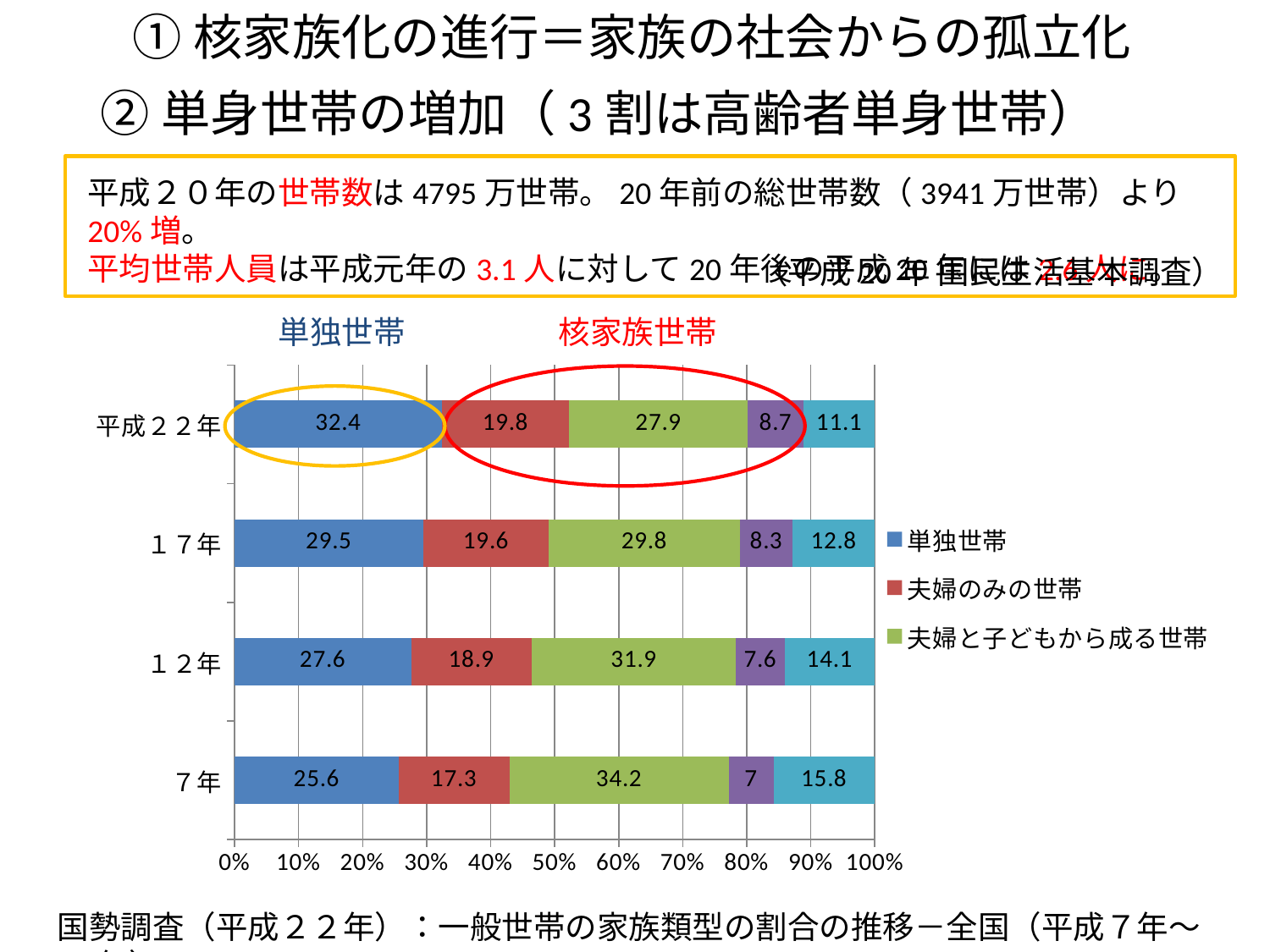
Does the value for 単独世帯 rise or fall from 7年 to 平成22年? Rise Which year has the highest value for 単独世帯? 平成22年 How many years (categories) are shown in the chart? 4 What is the difference between the 夫婦と子どもから成る世帯 value in 7年 and in 平成22年? 6.3 In 12年, which is larger: 単独世帯 or 夫婦と子どもから成る世帯? 夫婦と子どもから成る世帯 What is the value for 夫婦と子どもから成る世帯 in 7年? 34.2 What is the difference between the 単独世帯 value in 平成22年 and in 7年? 6.8 What is the value for 夫婦のみの世帯 in 12年? 18.9 What is the value for 単独世帯 in 平成22年? 32.4 Which year has the lowest value for 夫婦と子どもから成る世帯? 平成22年 How many series does the legend list? 3 What kind of chart is shown on the slide? Stacked bar chart